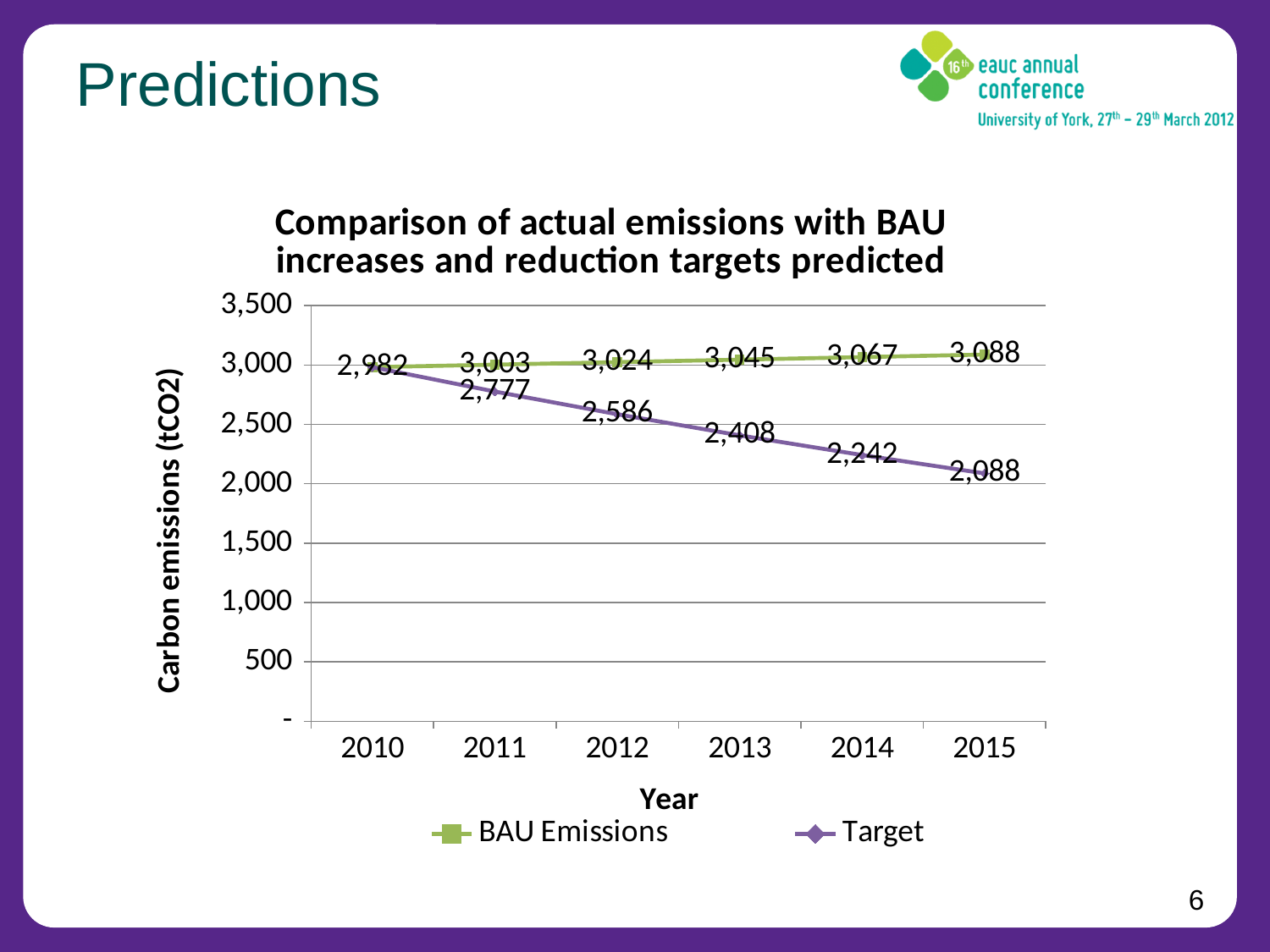
What is the Target value for 2015? 2,088 In which year is the BAU Emissions value highest? 2015 How many series does the legend list? 2 Does the Target series rise or fall from 2010 to 2015? fall What is the BAU Emissions value for 2010? 2,982 Which is larger in 2013, the BAU Emissions value or the Target value? BAU Emissions What is the BAU Emissions value for 2013? 3,045 What is the difference between the Target values for 2011 and 2012? 191 What is the Target value for 2014? 2,242 What type of chart is shown on the slide? line chart What is the difference between the BAU Emissions and Target values in 2015? 1,000 In which year is the Target value lowest? 2015